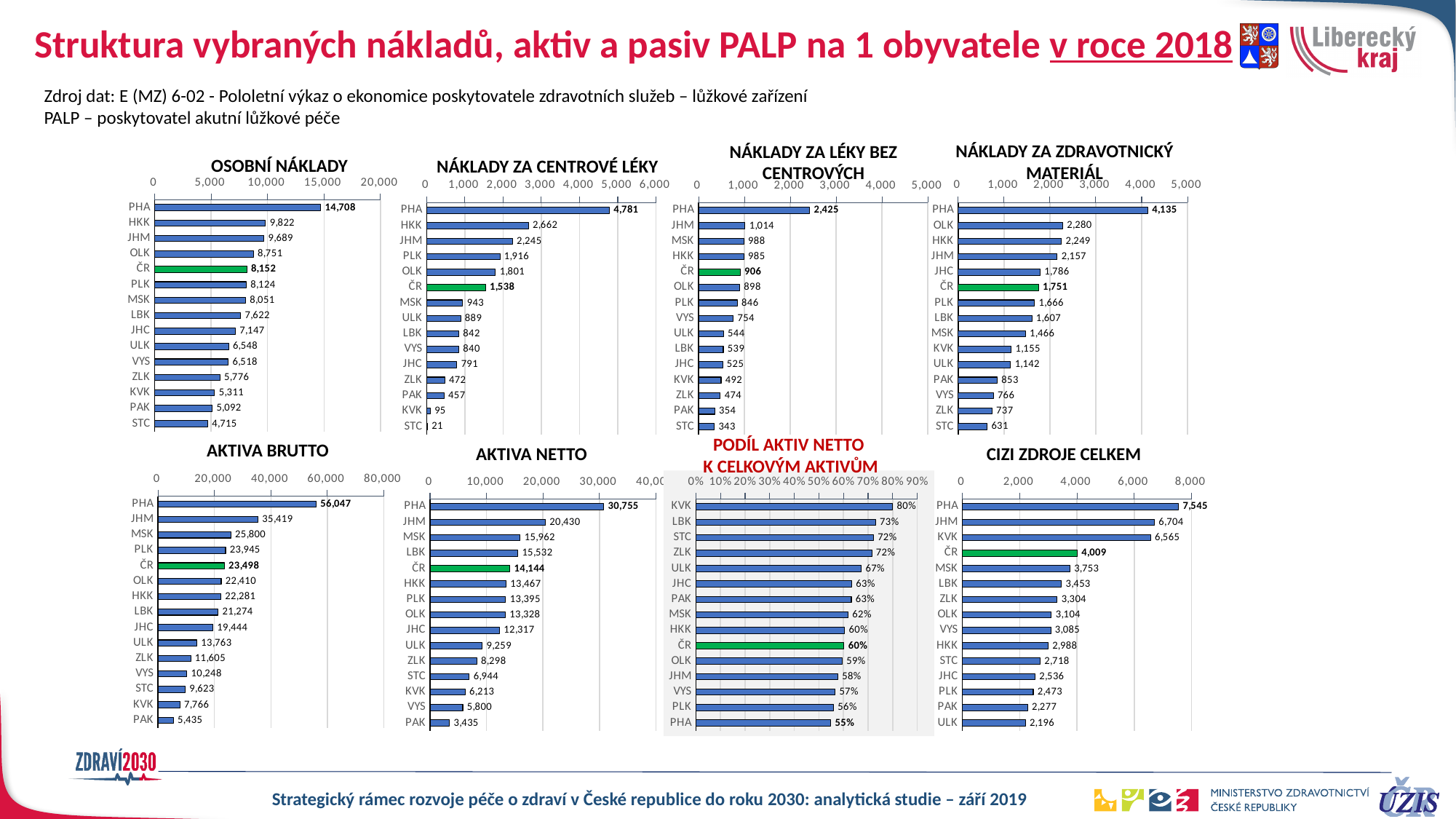
In the NÁKLADY ZA ZDRAVOTNICKÝ MATERIÁL chart, how many categories are shown? 15 In the OSOBNÍ NÁKLADY chart, what is the value for LBK? 7,622 In the AKTIVA NETTO chart, which is larger, the value for LBK or the value for ČR? LBK In the OSOBNÍ NÁKLADY chart, which category has the lowest value? STC In the CIZI ZDROJE CELKEM chart, what is the difference between the values for PHA and ČR? 3,536 What kind of chart is the CIZI ZDROJE CELKEM chart? bar chart In the NÁKLADY ZA CENTROVÉ LÉKY chart, which category has the highest value? PHA In the PODÍL AKTIV NETTO K CELKOVÝM AKTIVŮM chart, which category has the lowest value? PHA In the NÁKLADY ZA CENTROVÉ LÉKY chart, what is the value for ČR? 1,538 In the NÁKLADY ZA LÉKY BEZ CENTROVÝCH chart, what is the value for VYS? 754 In the PODÍL AKTIV NETTO K CELKOVÝM AKTIVŮM chart, what is the value for KVK? 80% In the AKTIVA BRUTTO chart, what is the difference between the values for PHA and JHM? 20,628